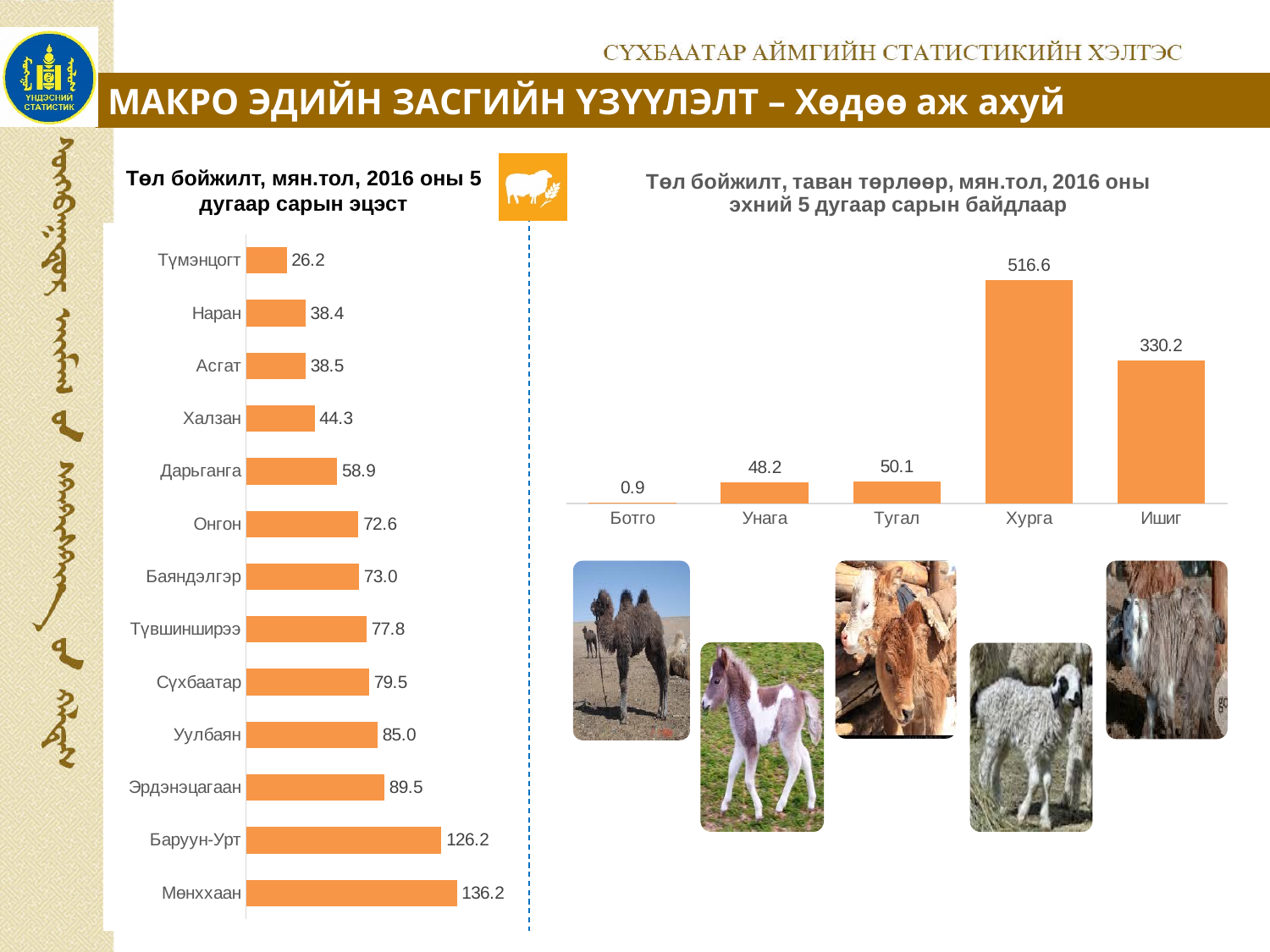
In the left chart, what is the value for Мөнххаан? 136.2 In the left chart, which is larger, Уулбаян or Сүхбаатар? Уулбаян In the right chart, what is the value for Ботго? 0.9 In the left chart, how many categories are shown? 13 In the right chart, what is the difference between Хурга and Ишиг? 186.4 In the left chart, what is the value for Дарьганга? 58.9 In the right chart, which category has the highest value? Хурга In the right chart, what is the value for Хурга? 516.6 In the left chart, what is the difference between Мөнххаан and Баруун-Урт? 10.0 What type of chart is the right chart? Bar chart In the left chart, which category has the highest value? Мөнххаан In the left chart, which category has the lowest value? Түмэнцогт